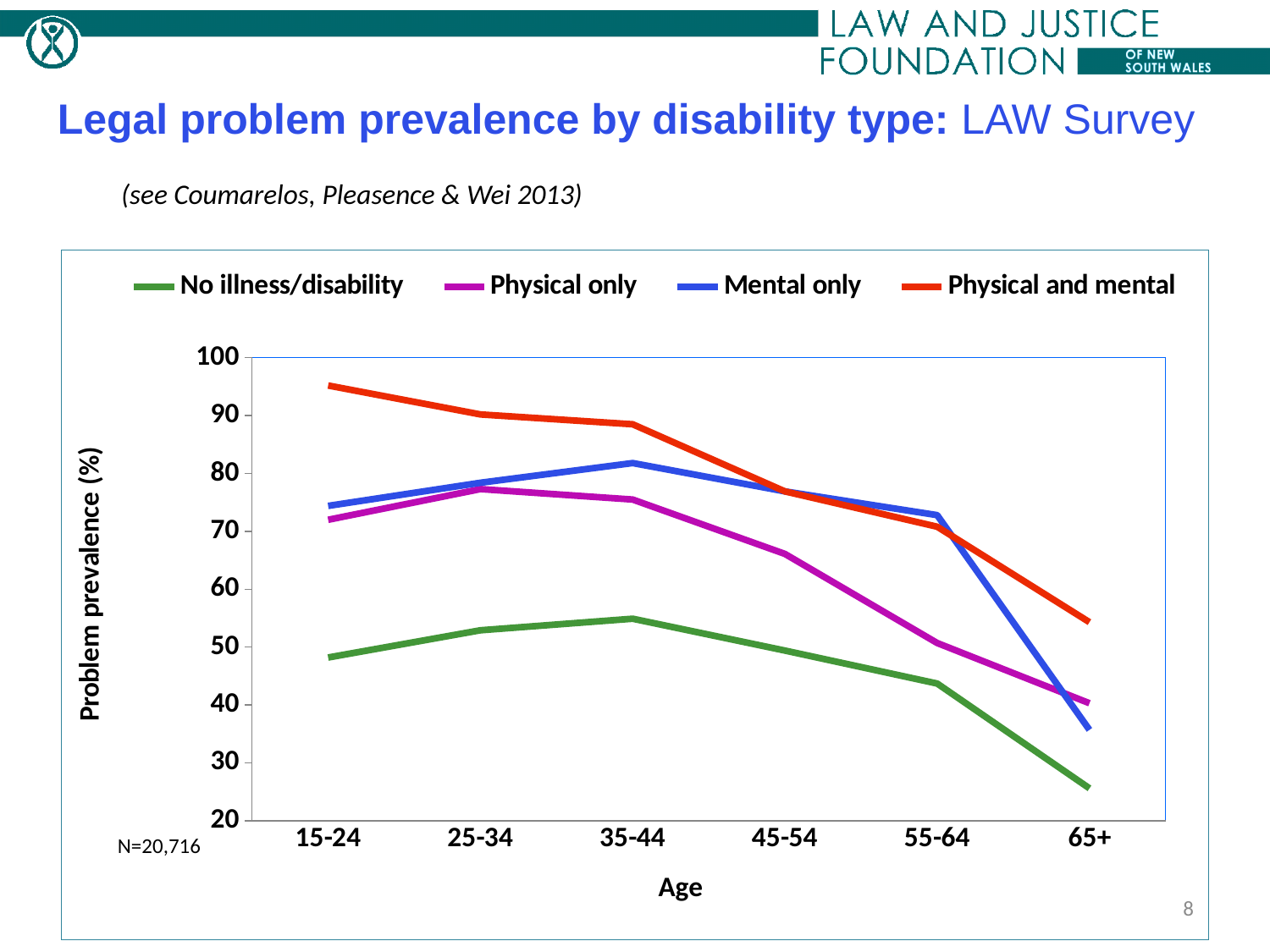
What kind of chart is shown on the slide? Line chart Which series has the highest problem prevalence at age 35-44? Physical and mental Is the value for Mental only at age 65+ greater or less than 40? less Is the value for No illness/disability at age 65+ greater or less than 30? less Which age group has the highest problem prevalence for the Physical and mental series? 15-24 Does the No illness/disability line rise or fall from age 35-44 to 65+? Fall How many series does the legend list? 4 Is the value for Physical and mental at age 15-24 greater or less than 90? greater At age 65+, which is larger: Physical and mental or Mental only? Physical and mental Which age group has the lowest problem prevalence for the No illness/disability series? 65+ How many age groups are shown on the x axis? 6 What is the label on the y axis of the chart? Problem prevalence (%)